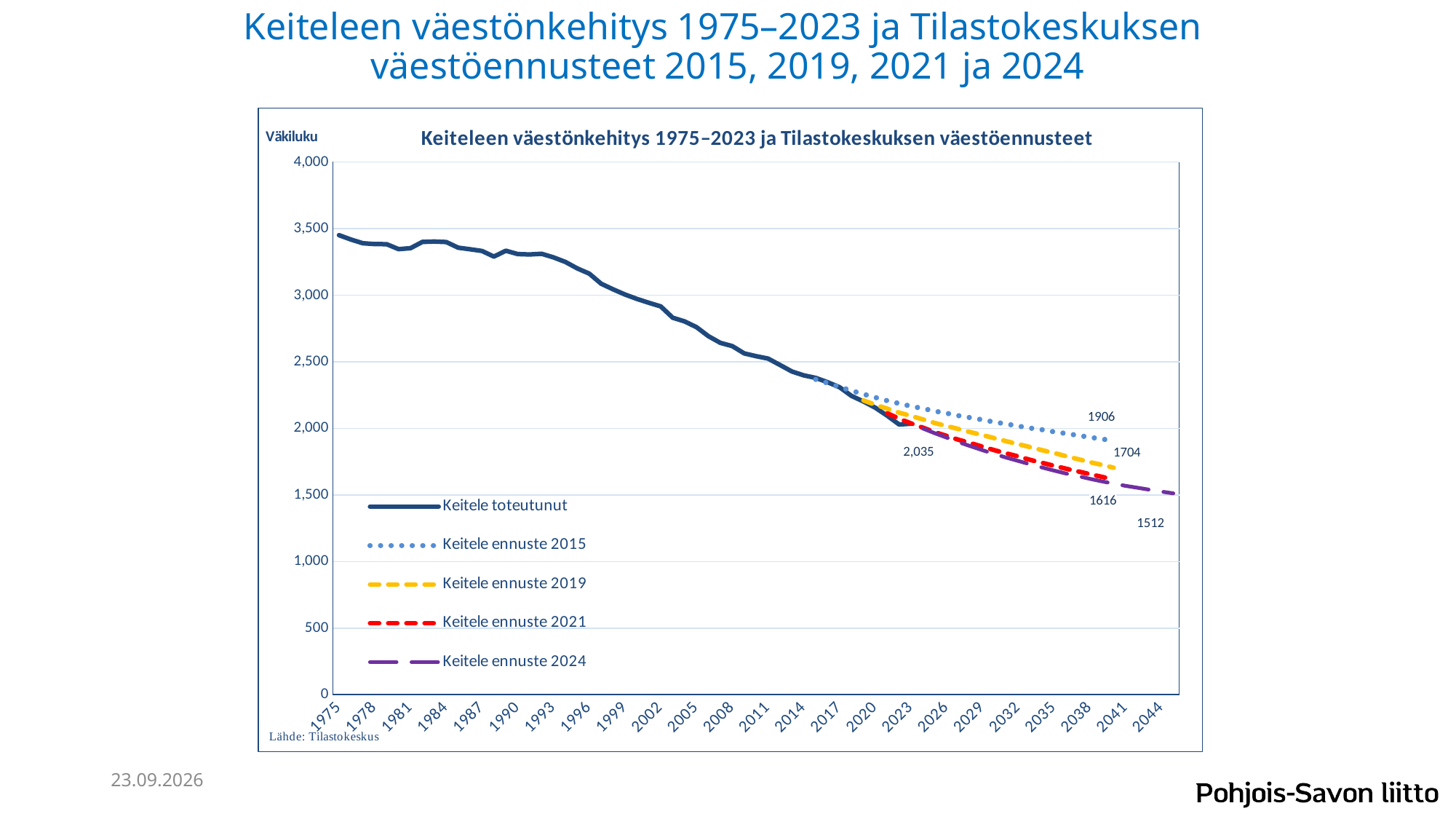
What is the difference between the labelled end values of Keitele ennuste 2015 (1906) and Keitele ennuste 2019 (1704)? 202 What is the labelled final value of the Keitele toteutunut series? 2,035 How many series does the legend list? 5 What is the difference between the labelled end values of Keitele ennuste 2021 (1616) and Keitele ennuste 2024 (1512)? 104 Which forecast series ends at the lowest labelled value? Keitele ennuste 2024 What is the labelled end value of the Keitele ennuste 2019 series? 1704 What is the labelled end value of the Keitele ennuste 2024 series? 1512 What kind of chart is shown on the slide? line chart What is the labelled end value of the Keitele ennuste 2015 series? 1906 Is the value of Keitele toteutunut in 1975 greater or less than 3,000? greater Which forecast series ends at the highest labelled value? Keitele ennuste 2015 Does the Keitele toteutunut series rise or fall from 1975 to 2023? fall